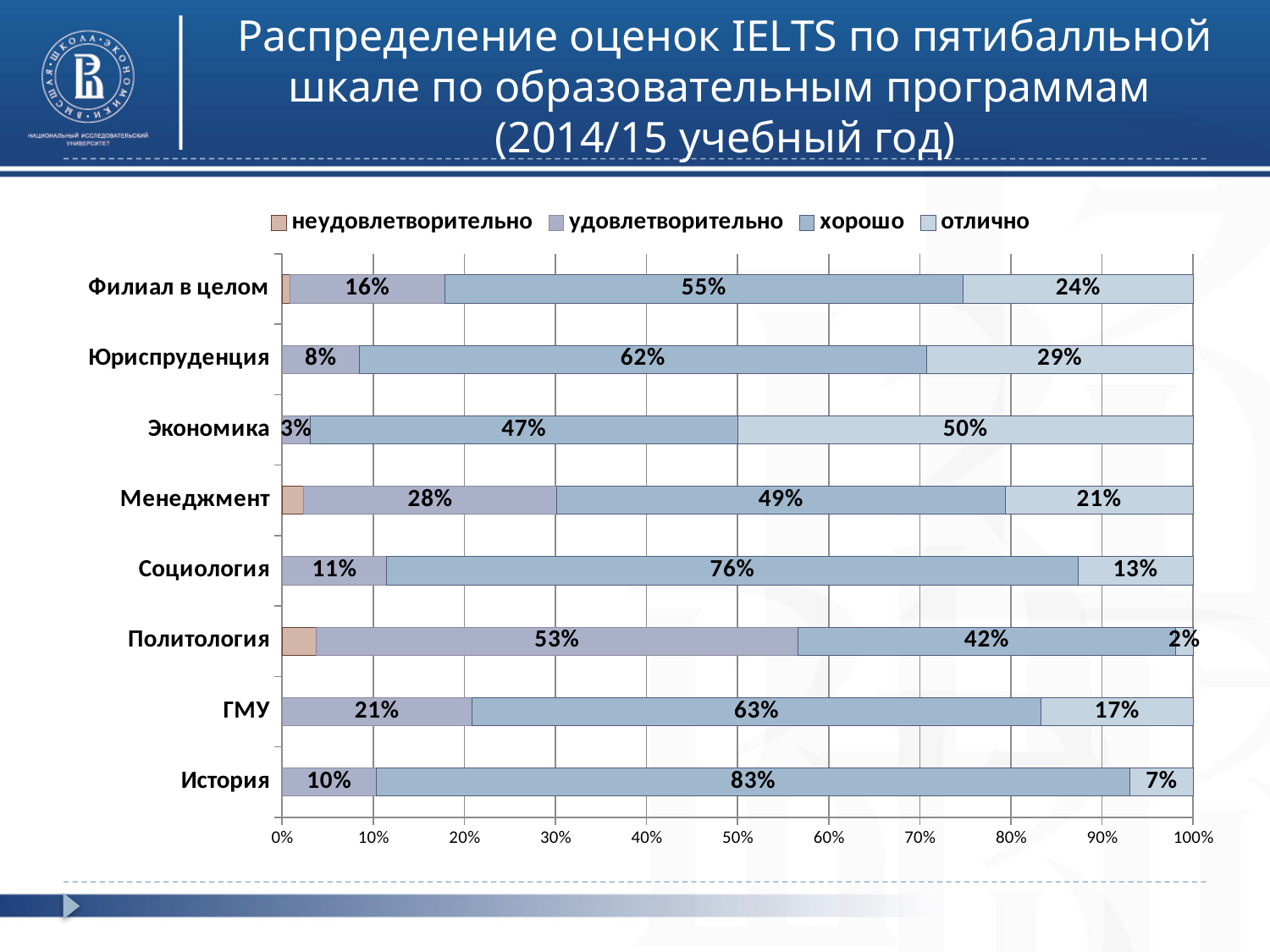
What is the difference between the хорошо values for История and Социология? 7% What percentage of students in Экономика received the grade отлично? 50% Which is larger: the отлично value for Юриспруденция or for ГМУ? Юриспруденция What kind of chart is shown on the slide? Stacked bar chart What is the value of the хорошо segment for История? 83% Which program has the highest хорошо value? История Which program has the lowest отлично value? Политология What share of Политология students received удовлетворительно? 53% Which grade category is listed first in the legend? неудовлетворительно What is the отлично value for Филиал в целом? 24% How many series does the legend list? 4 How many programs (categories) are shown on the chart? 8